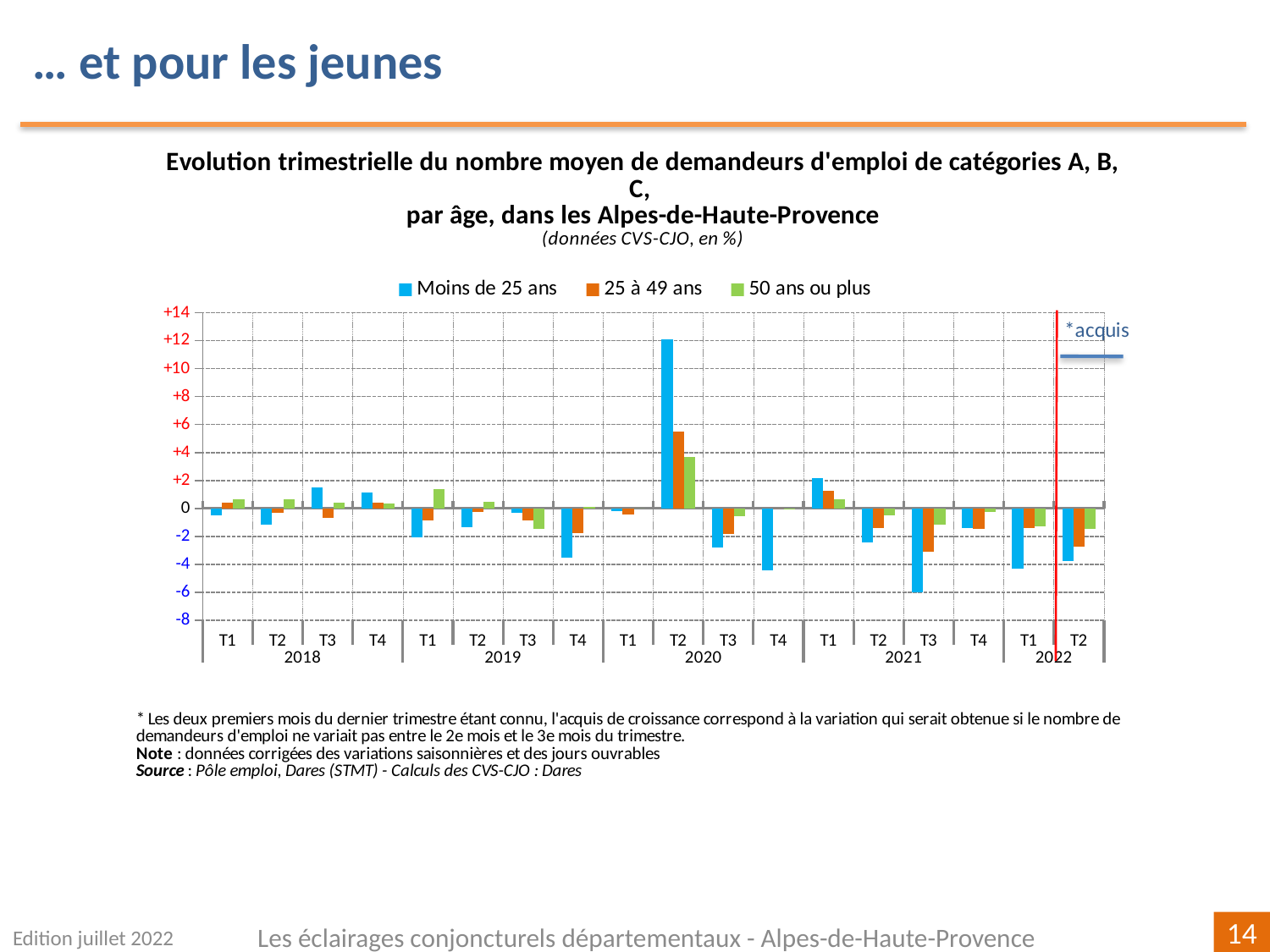
What kind of chart is shown on the slide? Bar chart How many series does the chart legend list? 3 In T2 2020, which series has the larger value: 'Moins de 25 ans' or '25 à 49 ans'? Moins de 25 ans Is the value for '25 à 49 ans' in T2 2020 greater or less than +4? greater How many quarters (categories) are plotted along the x axis? 18 Is the value for 'Moins de 25 ans' in T2 2020 greater or less than +10? greater In which quarter does the 'Moins de 25 ans' series reach its lowest value? T3 2021 Is the value for 'Moins de 25 ans' in T4 2020 greater or less than -2? less In T3 2021, which series has the higher value: 'Moins de 25 ans' or '25 à 49 ans'? 25 à 49 ans Which colour represents the 'Moins de 25 ans' series in the legend? Blue In which quarter does the 'Moins de 25 ans' series reach its highest value? T2 2020